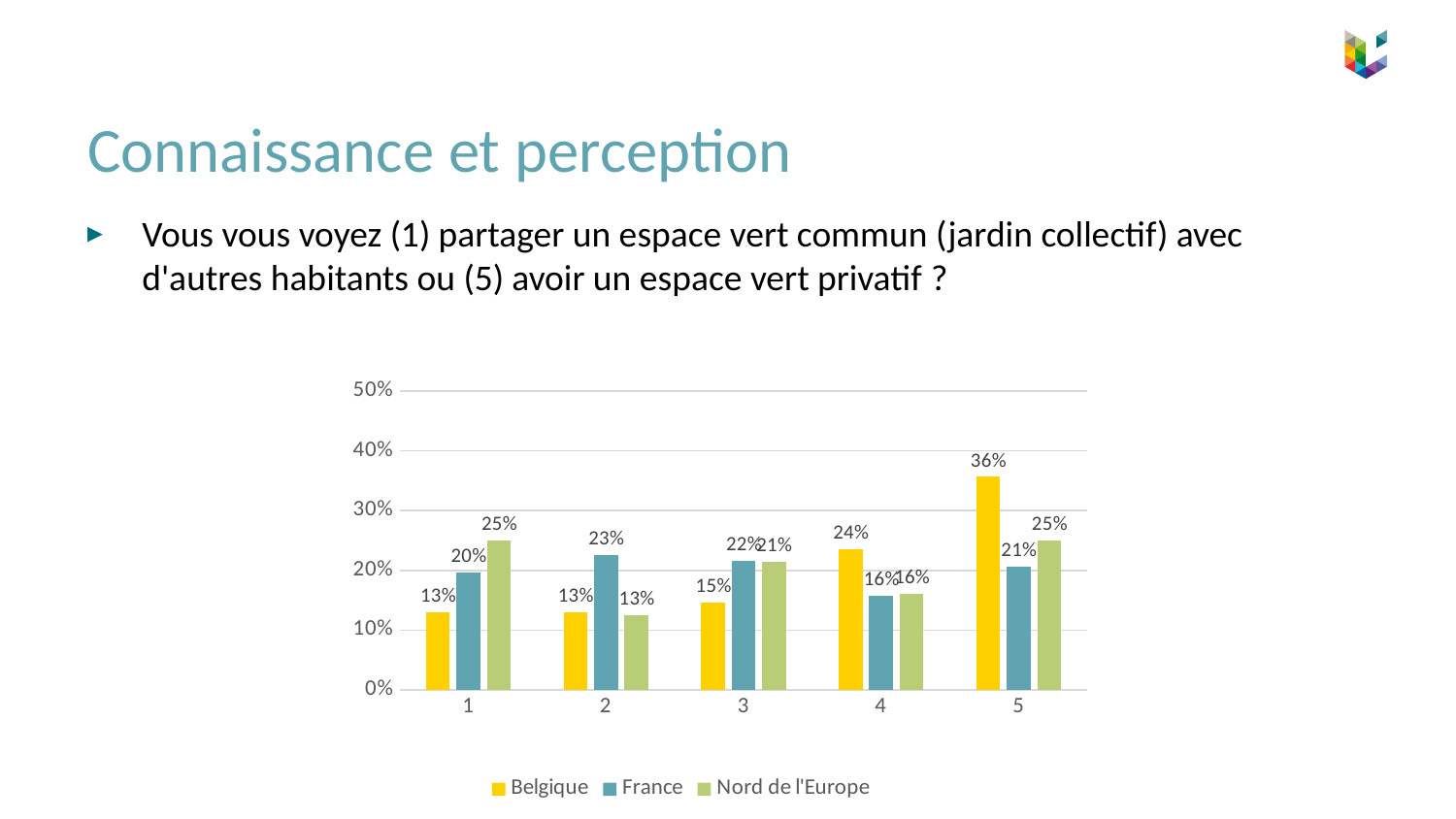
At category 1, which is larger: the value for France or the value for Nord de l'Europe? Nord de l'Europe How many categories are shown on the x axis? 5 Is the value for Belgique at category 5 greater or less than 30%? greater What is the value for Belgique at category 5? 36% What is the value for France at category 2? 23% What is the value for Belgique at category 4? 24% Which category has the highest value for Belgique? 5 What is the difference between the Belgique value and the France value at category 5? 15% What kind of chart is shown on the slide? bar chart What is the value for Nord de l'Europe at category 1? 25% How many series does the legend list? 3 Which category has the lowest value for France? 4